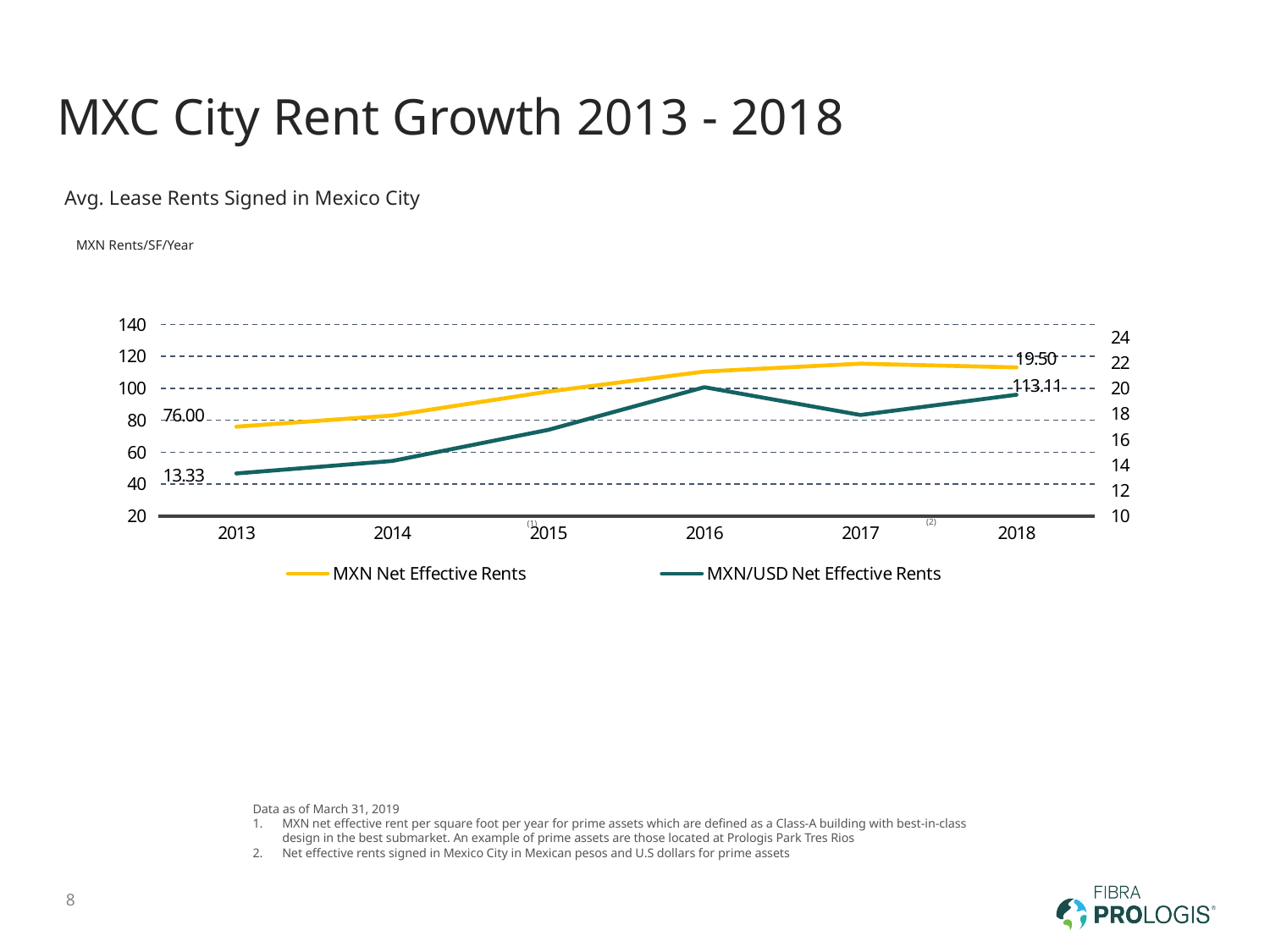
By how much did MXN/USD Net Effective Rents increase from 2013 to 2018? 6.17 Is the value for MXN Net Effective Rents in 2016 greater or less than 100? greater Which year has the lowest value for MXN Net Effective Rents? 2013 How many years are plotted on the x axis? 6 What is the value of MXN Net Effective Rents in 2018? 113.11 Do MXN Net Effective Rents rise or fall from 2013 to 2018? Rise How many series does the legend list? 2 By how much did MXN Net Effective Rents increase from 2013 to 2018? 37.11 What is the value of MXN/USD Net Effective Rents in 2013? 13.33 What is the value of MXN Net Effective Rents in 2013? 76.00 What is the value of MXN/USD Net Effective Rents in 2018? 19.50 What kind of chart is shown on the slide? Line chart